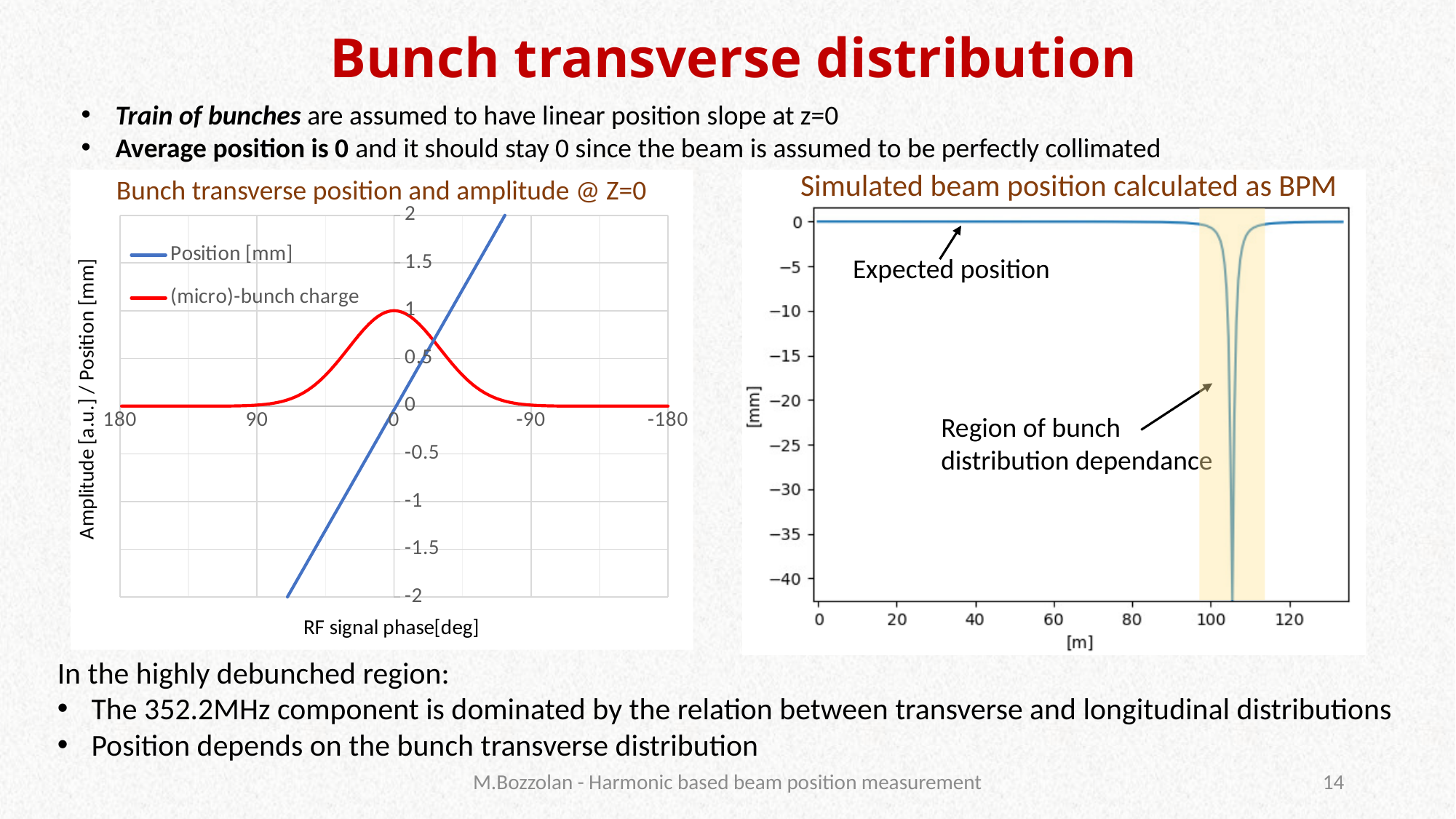
What kind of chart is the right chart titled "Simulated beam position calculated as BPM"? line chart In the right chart "Simulated beam position calculated as BPM", is the lowest point of the curve less or greater than -20 mm? less In the left chart "Bunch transverse position and amplitude @ Z=0", what colour is the (micro)-bunch charge series? red In the left chart "Bunch transverse position and amplitude @ Z=0", at which RF signal phase does the (micro)-bunch charge curve reach its maximum? 0 In the left chart "Bunch transverse position and amplitude @ Z=0", does the Position [mm] line rise or fall from left to right along the x axis? rise In the left chart "Bunch transverse position and amplitude @ Z=0", is the Position [mm] value at an RF signal phase of 90 deg greater or less than -1? less In the left chart "Bunch transverse position and amplitude @ Z=0", what are the two legend entries? Position [mm] and (micro)-bunch charge What kind of chart is the left chart titled "Bunch transverse position and amplitude @ Z=0"? line chart How many series does the legend of the left chart "Bunch transverse position and amplitude @ Z=0" list? 2 In the left chart "Bunch transverse position and amplitude @ Z=0", is the peak value of the (micro)-bunch charge curve greater or less than 0.5? greater